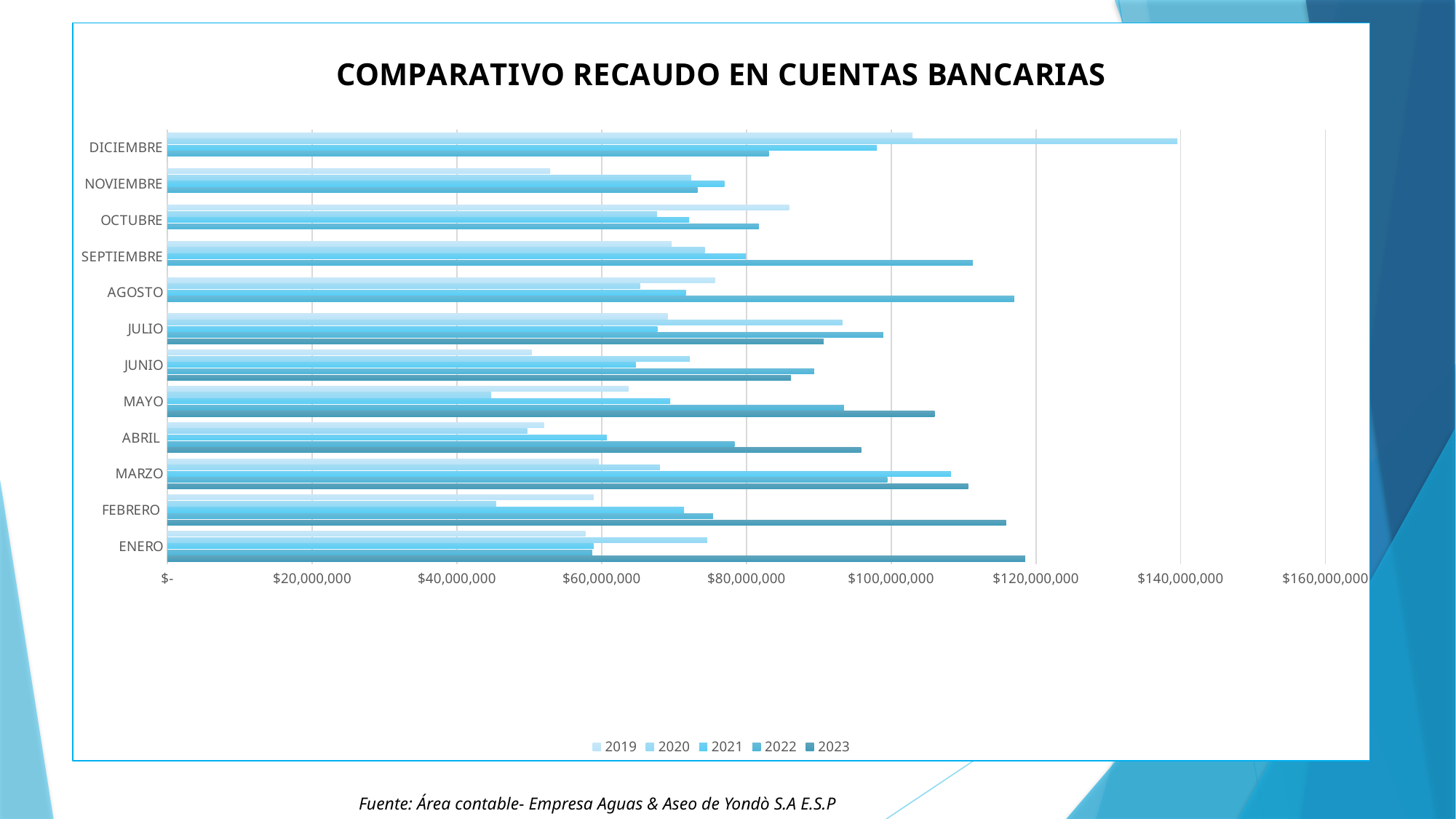
Is the value for 2023 in ENERO greater or less than $100,000,000? greater Is the value for 2022 in AGOSTO greater or less than $100,000,000? greater In ENERO, which is larger: the value for 2023 or the value for 2019? 2023 In DICIEMBRE, which is larger: the value for 2020 or the value for 2022? 2020 Which month contains the longest bar in the chart? DICIEMBRE How many series does the legend list? 5 Is the value for 2020 in DICIEMBRE greater or less than $120,000,000? greater What type of chart is shown on the slide? Bar chart What is the title of the chart? COMPARATIVO RECAUDO EN CUENTAS BANCARIAS Which years are listed in the legend? 2019, 2020, 2021, 2022, 2023 How many months (categories) are shown on the vertical axis? 12